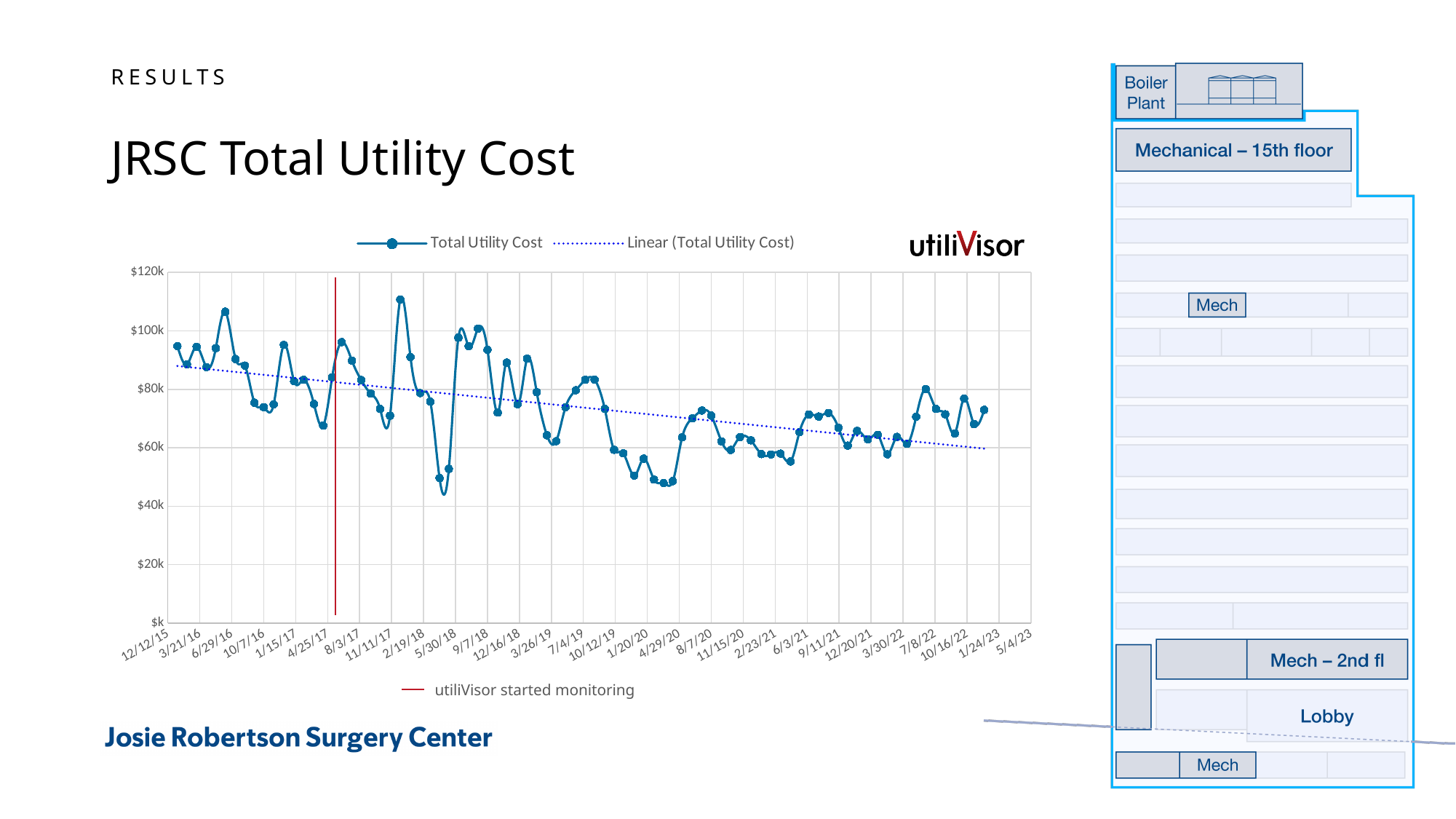
Is the Total Utility Cost at the last point (1/24/23) greater or less than $60k? greater Is the Total Utility Cost at the first point (12/12/15) larger or smaller than at the last point (1/24/23)? larger Is the Total Utility Cost at the first point (12/12/15) greater or less than $80k? greater Does the Total Utility Cost ever exceed $100k on the chart? yes What is the title of the chart? JRSC Total Utility Cost Does the Total Utility Cost generally rise or fall over time along the x axis? fall What is the highest value shown on the y axis? $120k How many series does the chart legend list? 2 What kind of chart is shown on the slide? line chart What does the red vertical line on the chart indicate? utiliVisor started monitoring